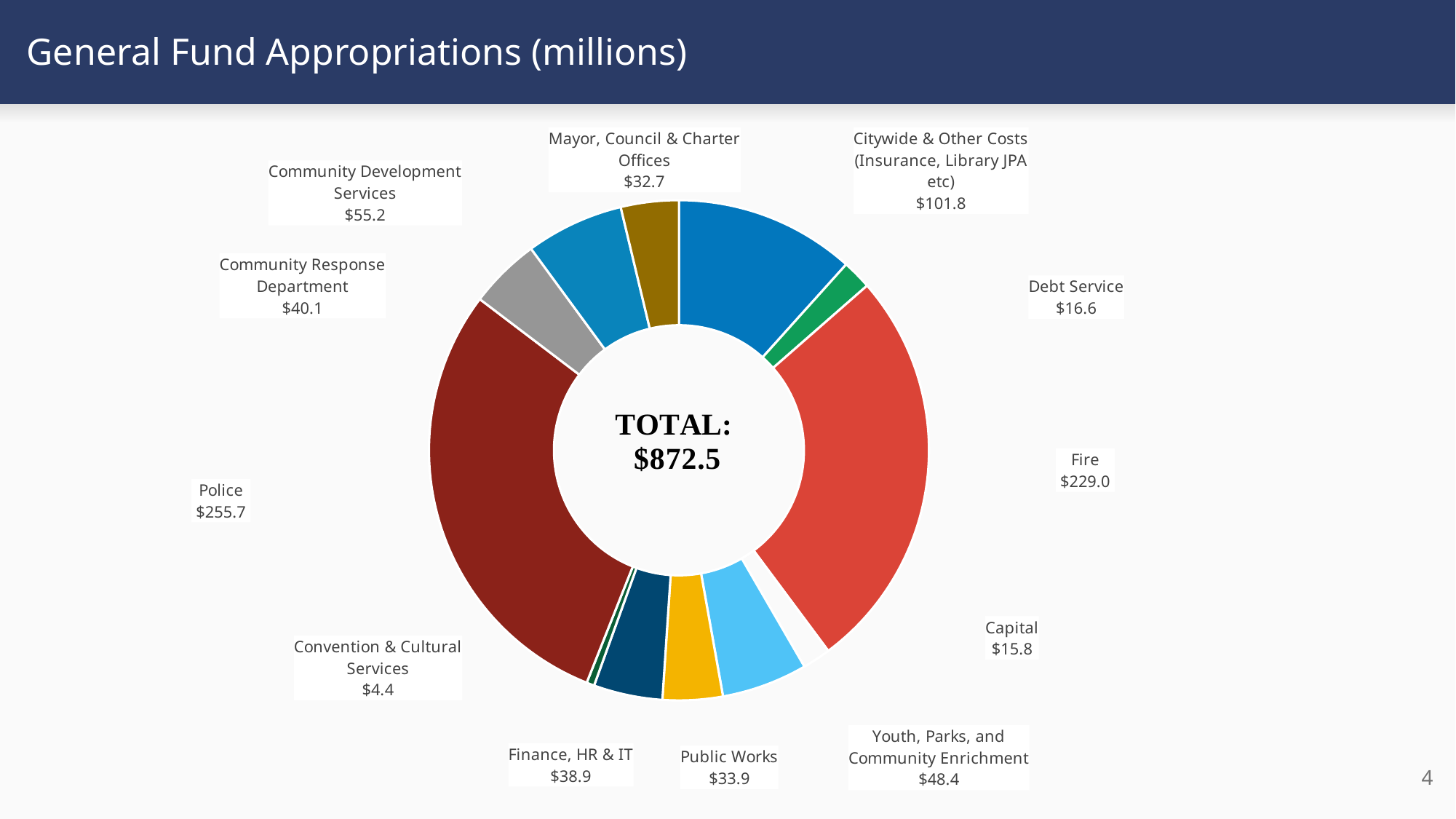
Which is larger, Finance, HR & IT or Public Works? Finance, HR & IT What is the value for Debt Service? $16.6 What is the value for Police? $255.7 Which is larger, Community Development Services or Community Response Department? Community Development Services What is the title of the slide? General Fund Appropriations (millions) What is the total shown in the centre of the chart? $872.5 Which category has the lowest value? Convention & Cultural Services What is the value for Youth, Parks, and Community Enrichment? $48.4 What kind of chart is shown on the slide? Doughnut (pie) chart How many categories are shown in the chart? 12 What is the difference between the Police and Fire values? $26.7 Which category has the highest value? Police